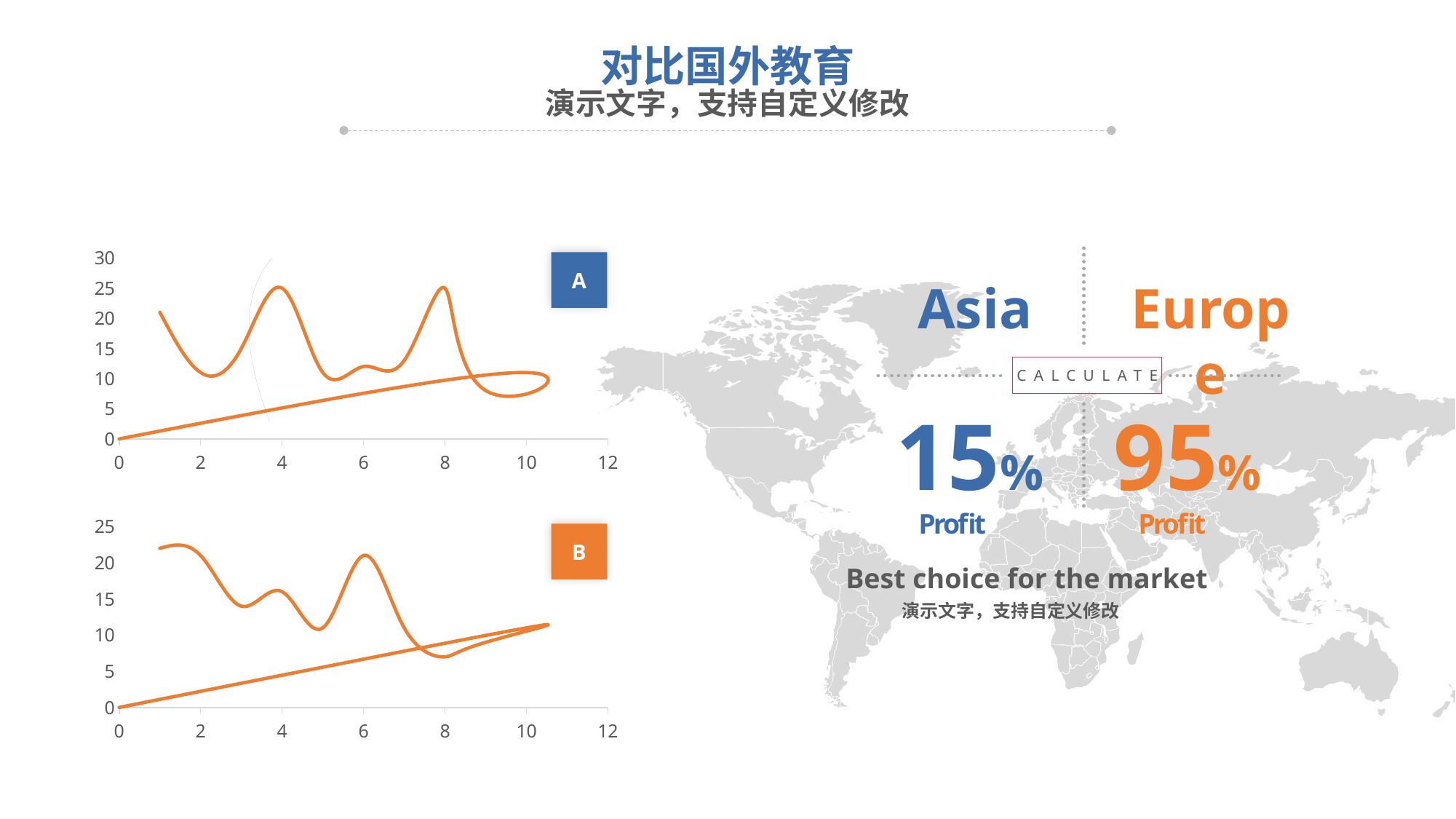
What kind of chart is chart A (the top chart)? line chart In chart B (the bottom chart), is the value of the wavy line at x = 1 greater or less than 20? greater In chart A (the top chart), does the straight line rise or fall as x increases from 0 to 10? rise In chart B (the bottom chart), is the value of the wavy line at x = 8 greater or less than 10? less In chart A (the top chart), is the value of the wavy line at x = 8 greater or less than 20? greater In chart A (the top chart), what is the highest value shown on the vertical axis? 30 What kind of chart is chart B (the bottom chart)? line chart How many charts are shown on the slide? 2 In chart B (the bottom chart), what is the highest value shown on the vertical axis? 25